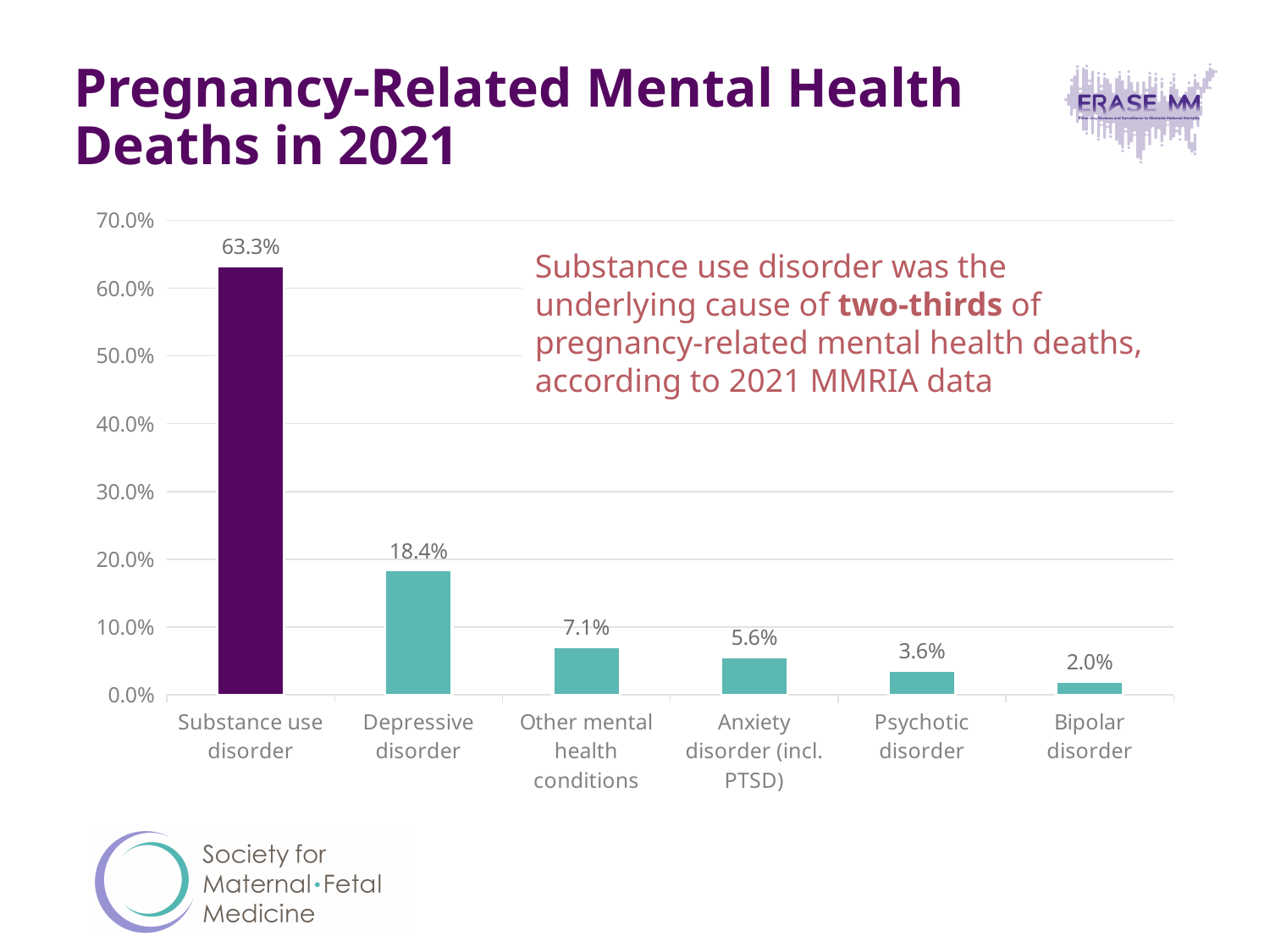
How many categories are shown on the x axis of the chart? 6 Which is larger, the value for anxiety disorder (incl. PTSD) or the value for psychotic disorder? Anxiety disorder (incl. PTSD) What kind of chart is shown on the slide? Bar chart What is the value shown for bipolar disorder? 2.0% What is the value shown for depressive disorder? 18.4% What is the difference between the values for substance use disorder and depressive disorder? 44.9% What is the value shown for anxiety disorder (incl. PTSD)? 5.6% Which category has the highest value in the chart? Substance use disorder Is the value for depressive disorder greater or less than 20.0%? less What is the difference between the values for other mental health conditions and psychotic disorder? 3.5% What percentage of pregnancy-related mental health deaths in 2021 had substance use disorder as the underlying cause? 63.3% Which category has the lowest value in the chart? Bipolar disorder